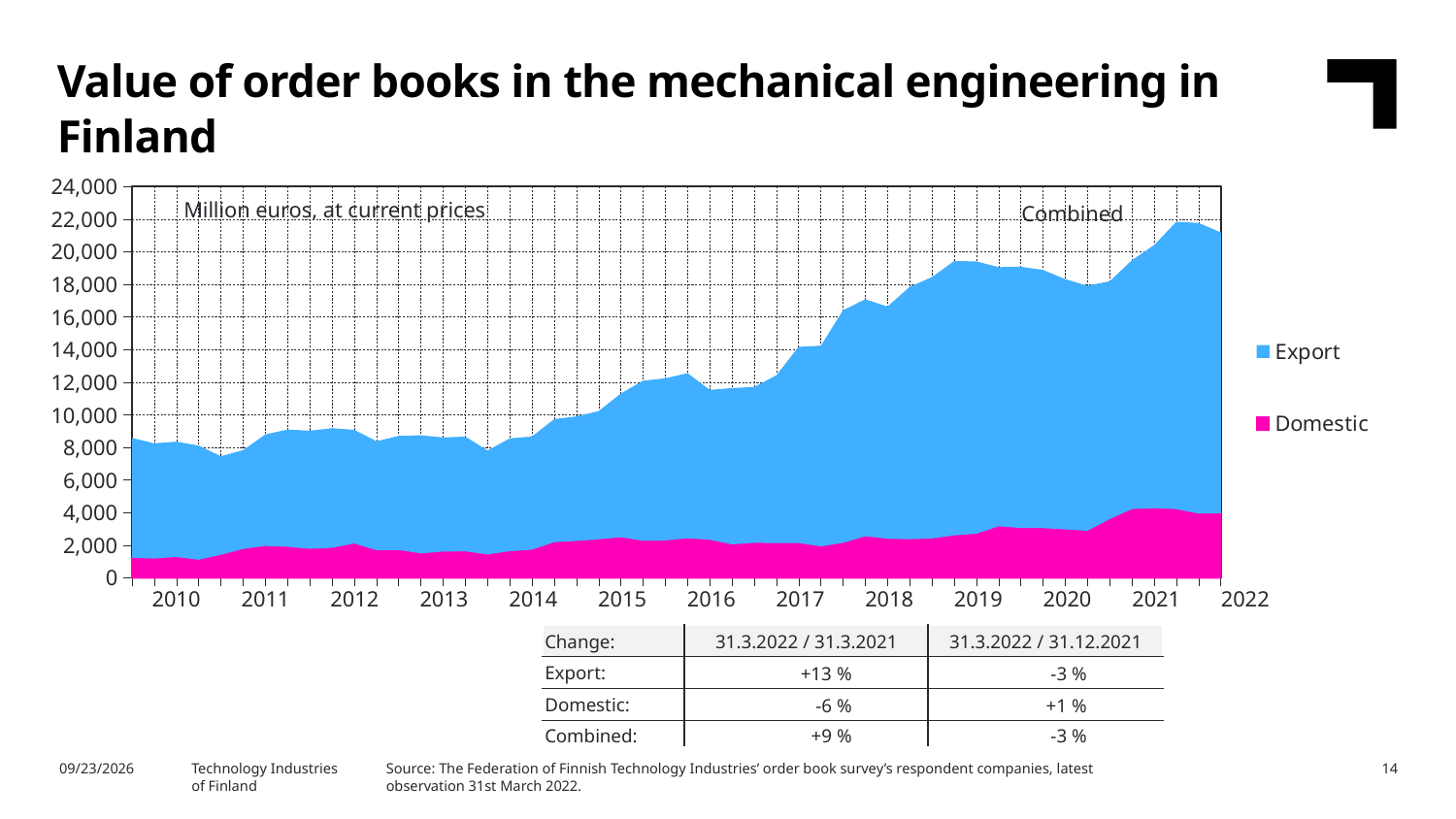
Is the combined value at its 2021 peak greater or less than 20,000? greater In which year does the combined value of order books reach its highest level? 2021 Is the Domestic value in 2010 greater or less than 2,000? less Does the combined value of order books generally rise or fall from 2010 to 2022? rise Is the Domestic value in 2021 greater or less than 2,000? greater What type of chart is shown on the slide? Area chart What unit is stated in the label inside the chart area? Million euros, at current prices How many series does the chart legend list? 2 Which series, Export or Domestic, has the larger values throughout the chart? Export What are the two series named in the chart legend? Export and Domestic